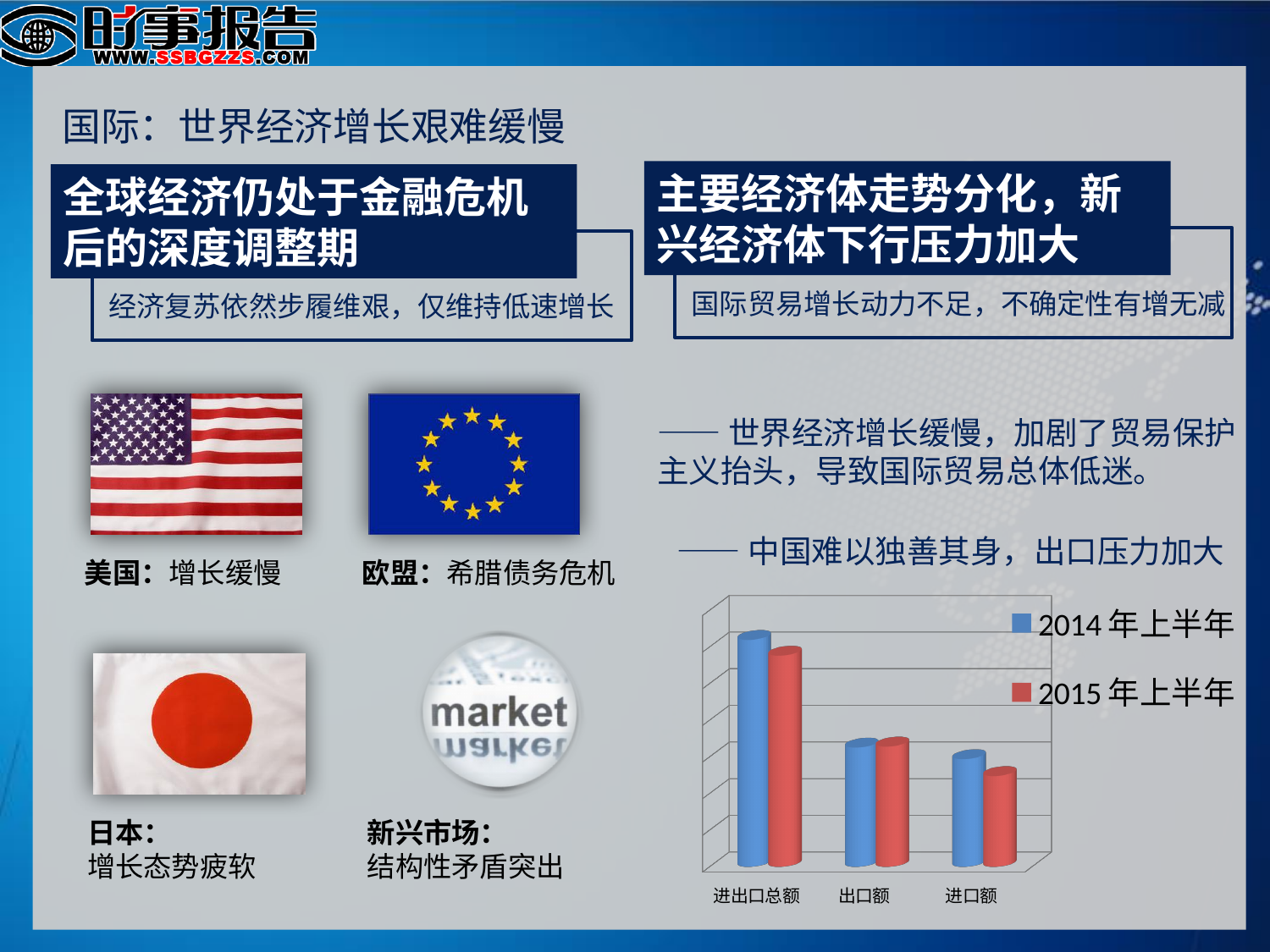
Which category has the highest value for 2014年上半年? 进出口总额 Which series is shown in red in the bar chart? 2015年上半年 Do the values for 2014年上半年 rise or fall from left to right across the categories? fall Which category has the lowest value for 2014年上半年? 进口额 Which series is shown in blue in the bar chart? 2014年上半年 For 进出口总额, which is larger: 2014年上半年 or 2015年上半年? 2014年上半年 How many categories are shown on the x axis of the bar chart? 3 Which category has the lowest value for 2015年上半年? 进口额 For 进口额, which is larger: 2014年上半年 or 2015年上半年? 2014年上半年 What kind of chart is shown on the slide? bar chart How many series does the legend of the bar chart list? 2 Which category has the highest value for 2015年上半年? 进出口总额